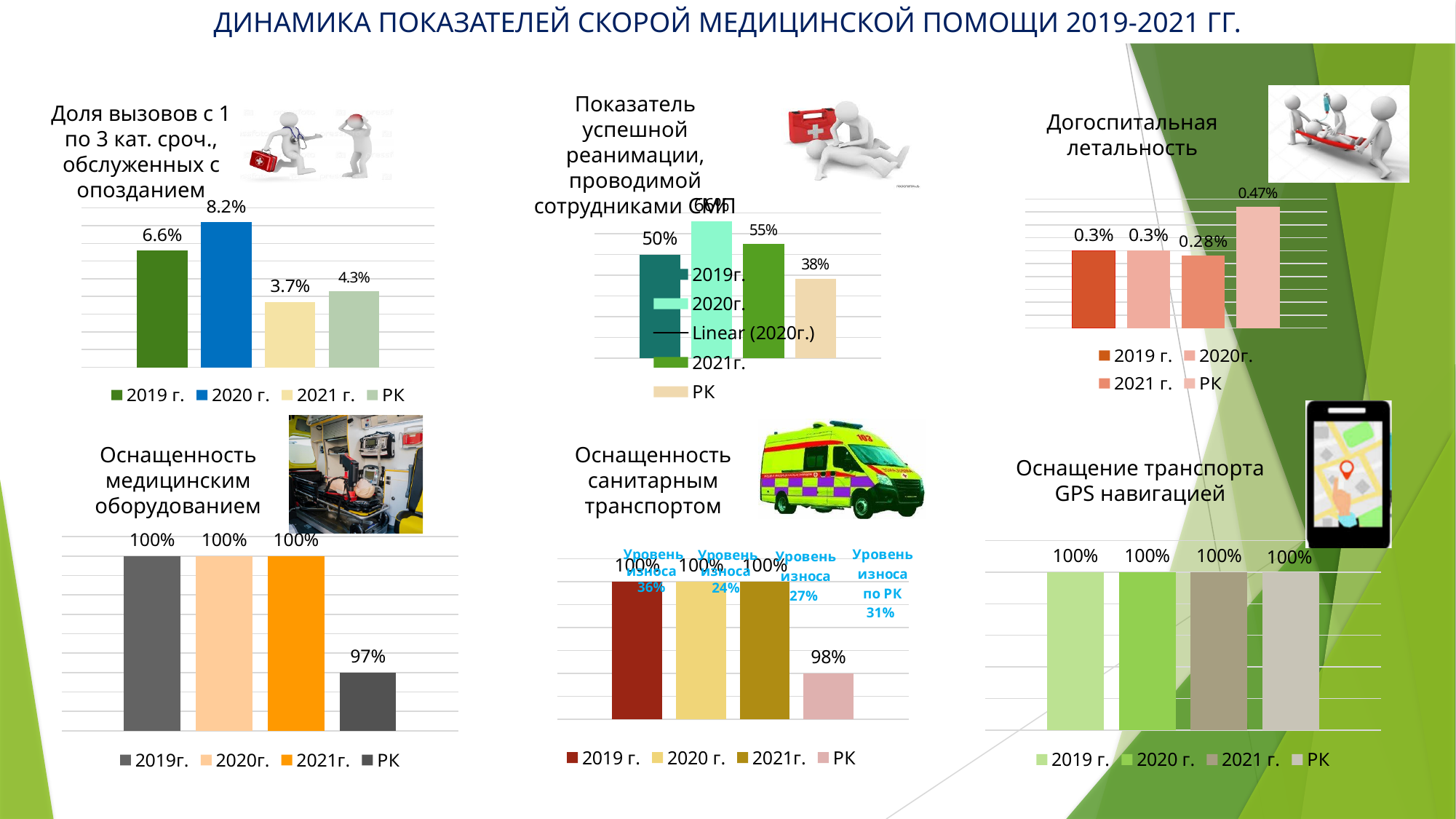
In the chart 'Оснащенность санитарным транспортом', what is the value for РК? 98% In the chart 'Оснащенность медицинским оборудованием', what is the value for РК? 97% In the chart 'Догоспитальная летальность', which category has the highest value? РК In the chart 'Доля вызовов с 1 по 3 кат. сроч., обслуженных с опозданием', what is the value for 2020 г.? 8.2% In the chart 'Доля вызовов с 1 по 3 кат. сроч., обслуженных с опозданием', what is the difference between the 2020 г. and 2019 г. values? 1.6% In the chart 'Догоспитальная летальность', what is the value for 2021 г.? 0.28% In the chart 'Догоспитальная летальность', what is the value for РК? 0.47% In the chart 'Доля вызовов с 1 по 3 кат. сроч., обслуженных с опозданием', which category has the lowest value? 2021 г. In the chart 'Показатель успешной реанимации, проводимой сотрудниками СМП', what is the value for РК? 38% In the chart 'Показатель успешной реанимации, проводимой сотрудниками СМП', which is larger, the value for 2019г. or the value for 2021г.? 2021г. What kind of chart is 'Оснащение транспорта GPS навигацией'? Bar chart How many series does the legend of the chart 'Оснащение транспорта GPS навигацией' list? 4